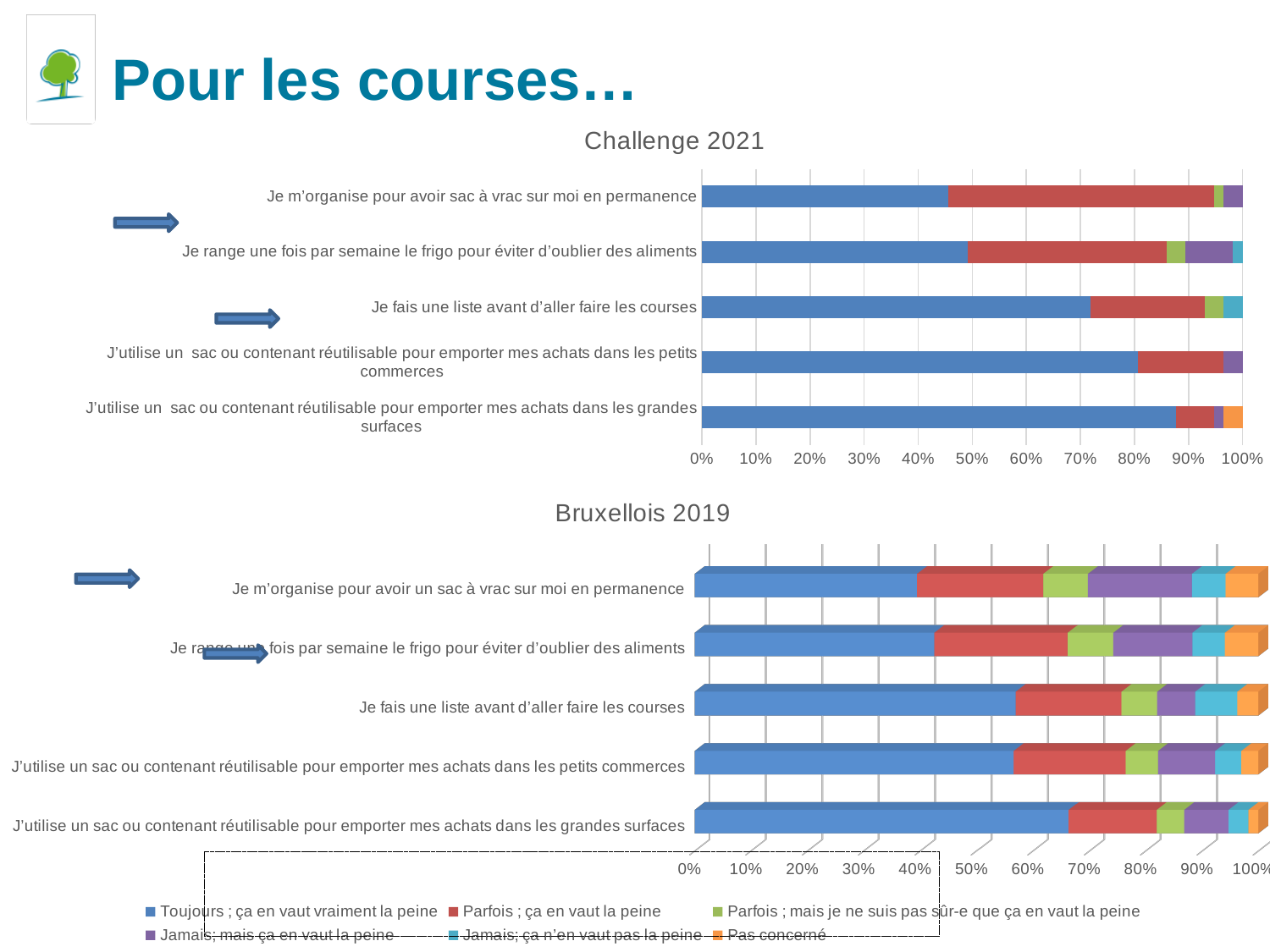
In the "Bruxellois 2019" chart, is the "Toujours ; ça en vaut vraiment la peine" share for "J'utilise un sac ou contenant réutilisable pour emporter mes achats dans les grandes surfaces" greater or less than 60%? greater In the "Challenge 2021" chart, is the "Toujours ; ça en vaut vraiment la peine" share for "Je fais une liste avant d'aller faire les courses" greater or less than 60%? greater In the "Bruxellois 2019" chart, is the "Toujours ; ça en vaut vraiment la peine" share for "Je m'organise pour avoir un sac à vrac sur moi en permanence" greater or less than 50%? less In the "Challenge 2021" chart, which has the larger "Toujours ; ça en vaut vraiment la peine" segment: "J'utilise un sac ou contenant réutilisable pour emporter mes achats dans les petits commerces" or "Je fais une liste avant d'aller faire les courses"? J'utilise un sac ou contenant réutilisable pour emporter mes achats dans les petits commerces What kind of chart is the "Challenge 2021" chart? Stacked bar chart In the "Challenge 2021" chart, which category has the largest "Toujours ; ça en vaut vraiment la peine" segment? J'utilise un sac ou contenant réutilisable pour emporter mes achats dans les grandes surfaces What is the title of the top chart on the slide? Challenge 2021 How many categories does the "Bruxellois 2019" chart show? 5 How many series does the legend at the bottom of the slide list? 6 In the "Bruxellois 2019" chart, which category has the largest "Toujours ; ça en vaut vraiment la peine" segment? J'utilise un sac ou contenant réutilisable pour emporter mes achats dans les grandes surfaces In the "Challenge 2021" chart, which category has the smallest "Toujours ; ça en vaut vraiment la peine" segment? Je m'organise pour avoir sac à vrac sur moi en permanence